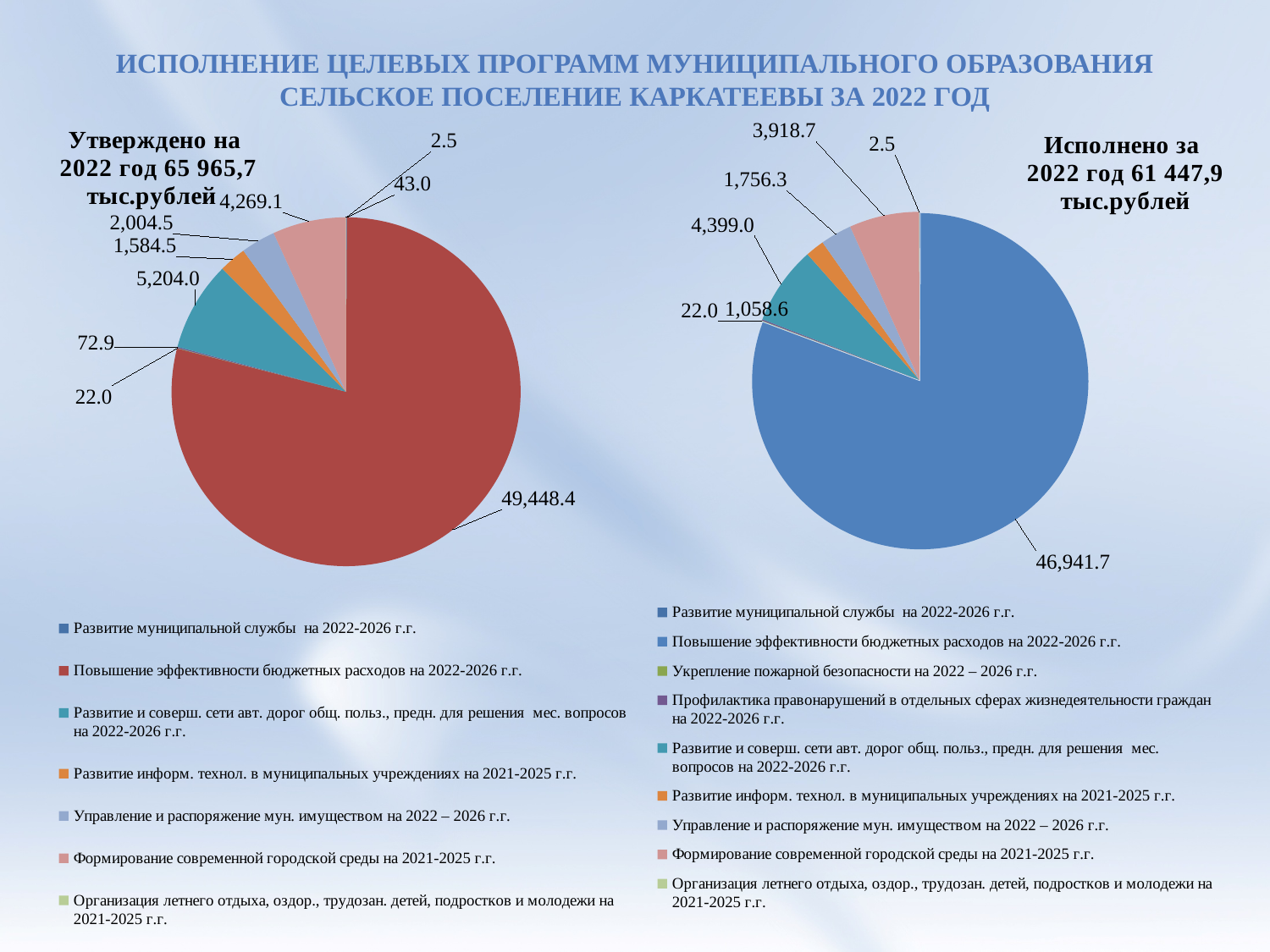
In the right pie chart (Исполнено за 2022 год), what is the value of the pink slice (Формирование современной городской среды)? 3,918.7 How many entries does the legend of the right pie chart (Исполнено за 2022 год) list? 9 How many entries does the legend of the left pie chart (Утверждено на 2022 год) list? 7 In the left pie chart (Утверждено на 2022 год), what is the value of the largest slice? 49,448.4 What is the difference between the largest slice of the left pie chart (49,448.4) and the largest slice of the right pie chart (46,941.7)? 2,506.7 In the left pie chart (Утверждено на 2022 год), what is the smallest labelled value? 2.5 According to the heading of the left chart, what total amount was approved (Утверждено) for 2022? 65 965,7 тыс.рублей Which is larger: the slice labelled 5,204.0 in the left pie chart or the slice labelled 4,399.0 in the right pie chart? 5,204.0 in the left pie chart In the right pie chart (Исполнено за 2022 год), what is the value of the largest slice? 46,941.7 What kind of chart is the left chart titled "Утверждено на 2022 год"? pie chart What is the difference between the value 5,204.0 in the left pie chart and the value 4,399.0 in the right pie chart? 805.0 According to the heading of the right chart, what total amount was executed (Исполнено) for 2022? 61 447,9 тыс.рублей